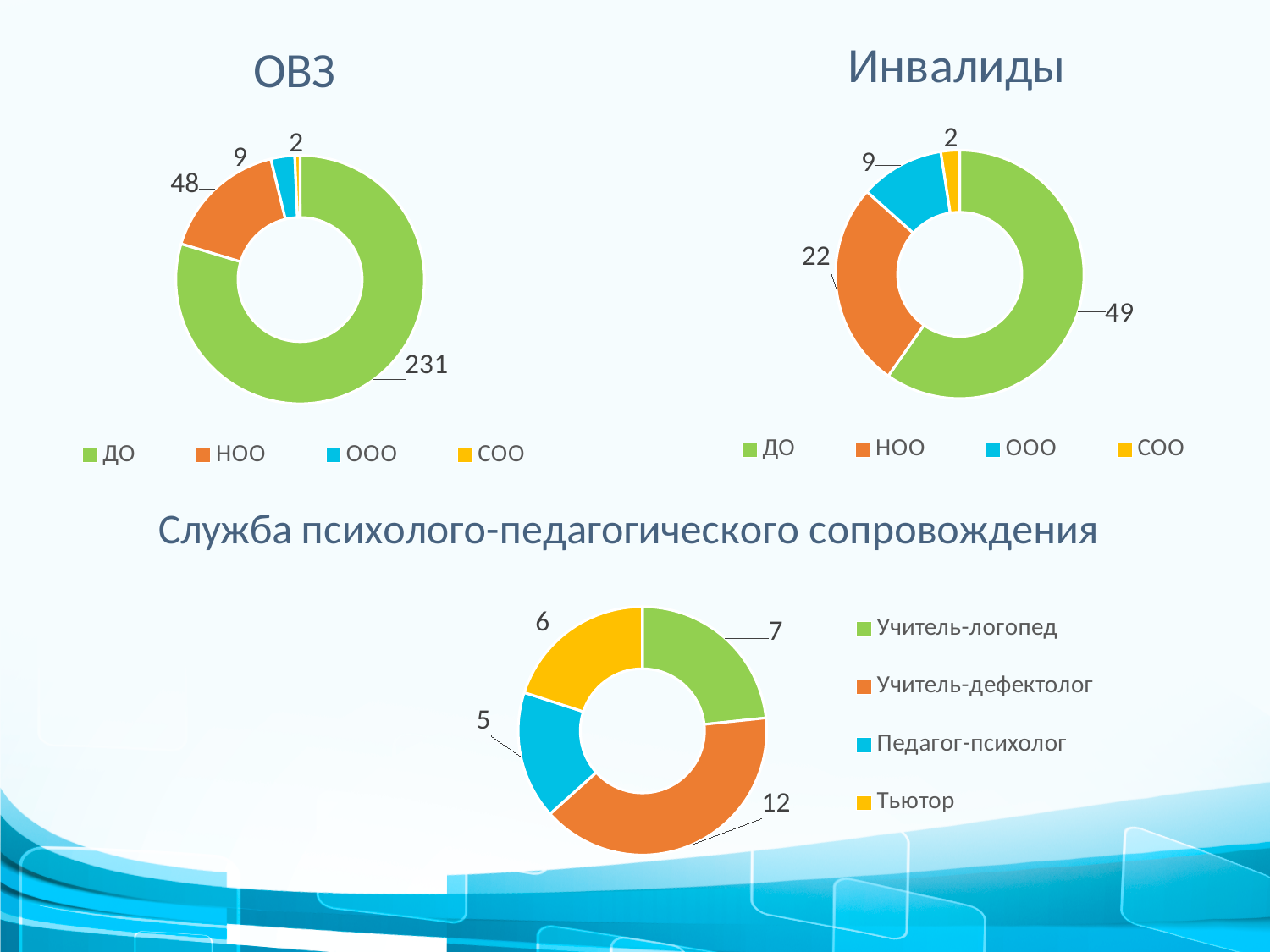
In the ОВЗ chart, what is the difference between the values for ДО and НОО? 183 In the Инвалиды chart, what is the value for НОО? 22 In the Инвалиды chart, which category has the largest value? ДО In the Служба психолого-педагогического сопровождения chart, which is larger: Учитель-логопед or Тьютор? Учитель-логопед In the ОВЗ chart, what is the value for НОО? 48 In the Инвалиды chart, which category has the smallest value? СОО In the Инвалиды chart, what is the difference between the values for ДО and ООО? 40 In the ОВЗ chart, what is the value for ДО? 231 What kind of chart is the ОВЗ chart? Doughnut chart How many categories does the Служба психолого-педагогического сопровождения chart show? 4 In the Служба психолого-педагогического сопровождения chart, what is the value for Учитель-дефектолог? 12 In the Служба психолого-педагогического сопровождения chart, what share of the total does Учитель-дефектолог represent? 40%